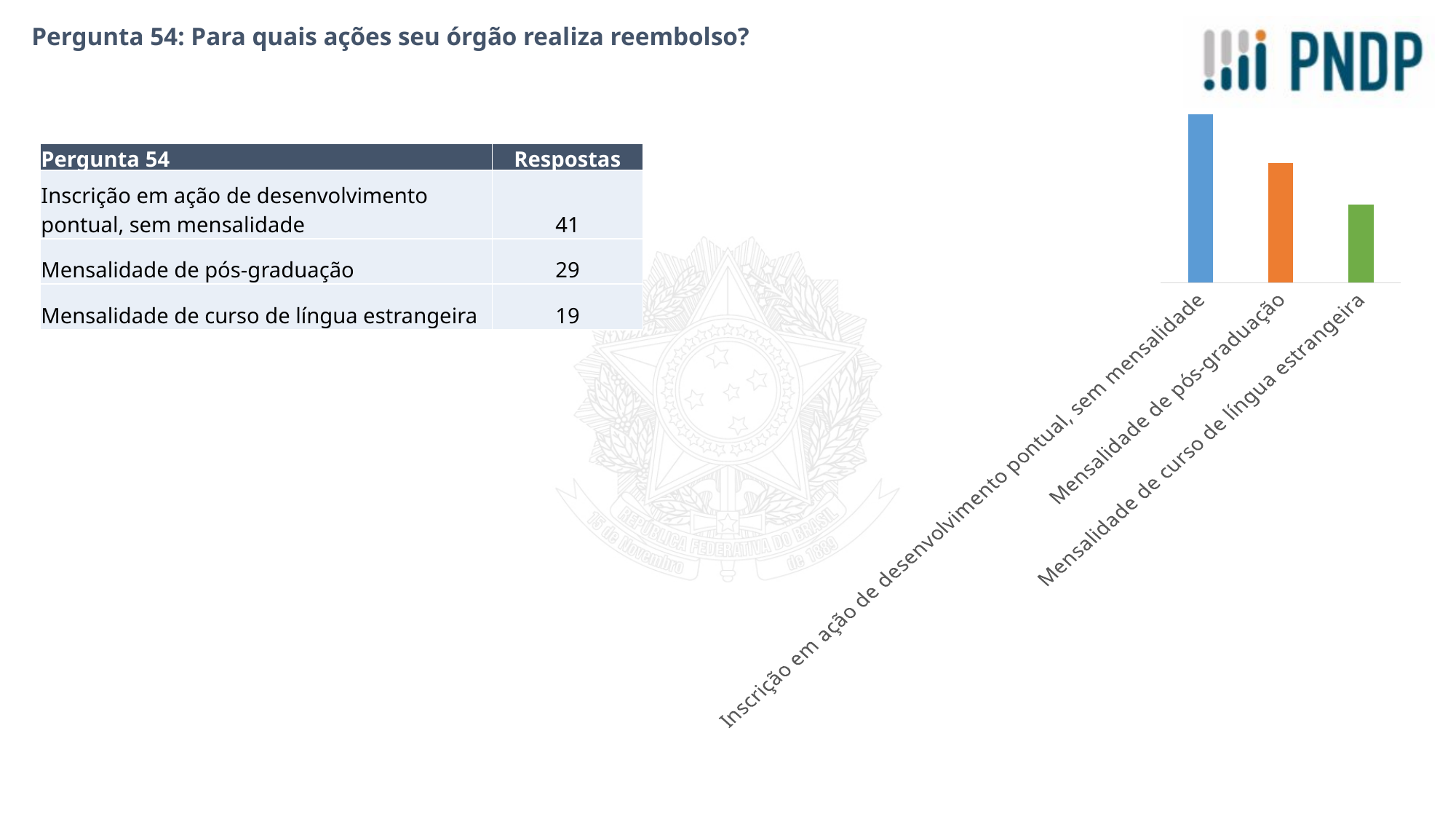
Which category has the lowest bar in the chart? Mensalidade de curso de língua estrangeira Which is larger: the bar for Mensalidade de pós-graduação or the bar for Mensalidade de curso de língua estrangeira? Mensalidade de pós-graduação What colour is the bar for Mensalidade de pós-graduação? orange Using the values printed on the slide, what is the difference between the responses for Inscrição em ação de desenvolvimento pontual, sem mensalidade and Mensalidade de curso de língua estrangeira? 22 According to the values printed on the slide, how many responses does the bar for Inscrição em ação de desenvolvimento pontual, sem mensalidade represent? 41 Do the bar heights rise or fall from left to right across the chart? fall According to the values printed on the slide, how many responses does the bar for Mensalidade de curso de língua estrangeira represent? 19 What kind of chart is shown on the slide? bar chart Which category has the highest bar in the chart? Inscrição em ação de desenvolvimento pontual, sem mensalidade Using the values printed on the slide, what is the difference between the responses for Mensalidade de pós-graduação and Mensalidade de curso de língua estrangeira? 10 According to the values printed on the slide, how many responses does the bar for Mensalidade de pós-graduação represent? 29 How many categories (bars) does the chart show? 3